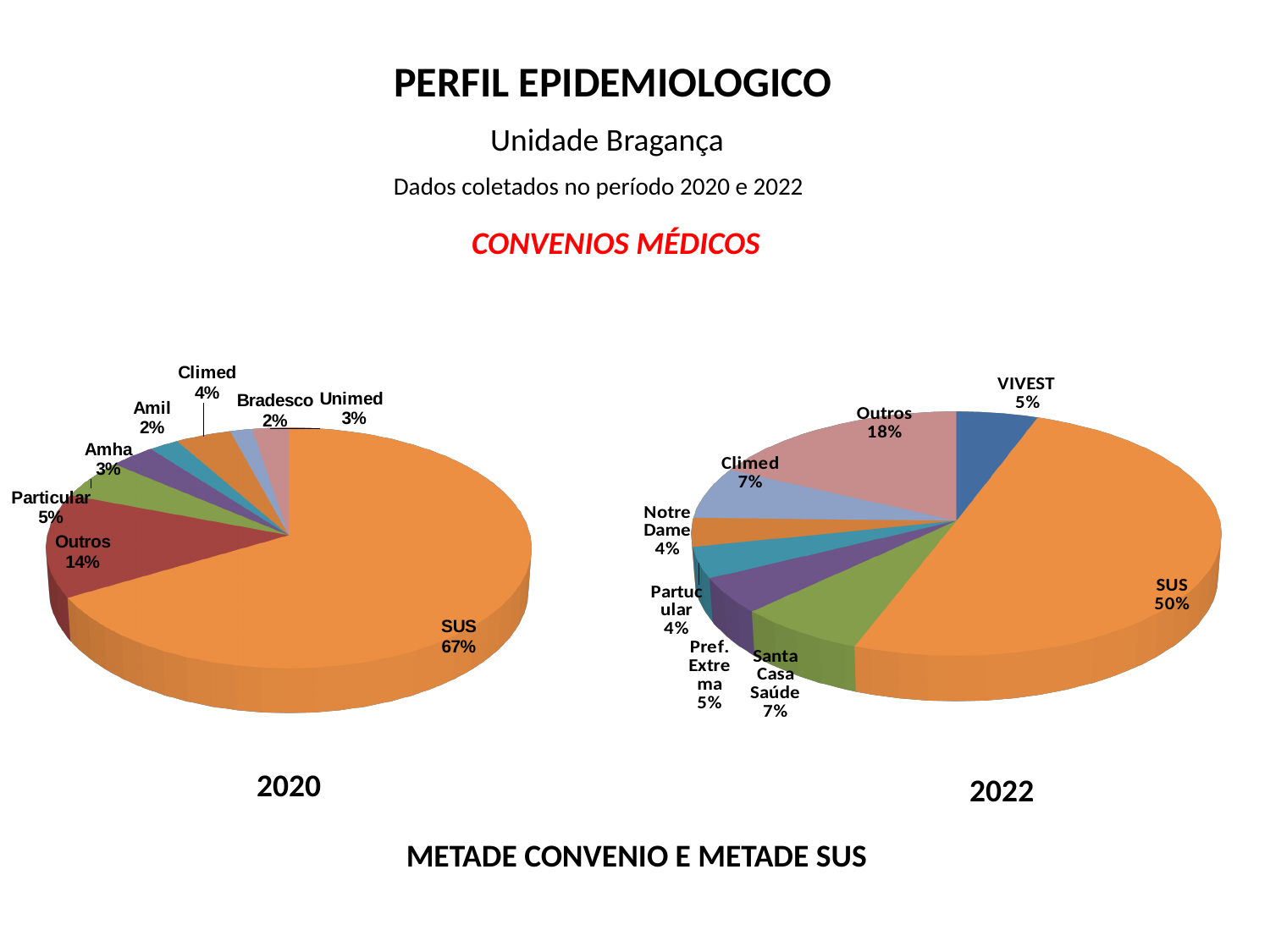
In the 2022 pie chart, which category has the largest share? SUS What is the red heading shown above the two charts? CONVENIOS MÉDICOS In the 2020 pie chart, what share does SUS have? 67% In the 2022 pie chart, what is the difference between the Outros share and the Climed share? 11% How many slices does the 2020 pie chart have? 8 In the 2022 pie chart, what share does SUS have? 50% In the 2020 pie chart, what is the difference between the SUS share and the Outros share? 53% In the 2022 pie chart, what is the share for Outros? 18% In the 2020 pie chart, which category has the largest share? SUS In the 2022 pie chart, which is larger, the share for VIVEST or the share for Santa Casa Saúde? Santa Casa Saúde What type of chart is used for the 2022 data? Pie chart In the 2020 pie chart, what is the share for Climed? 4%